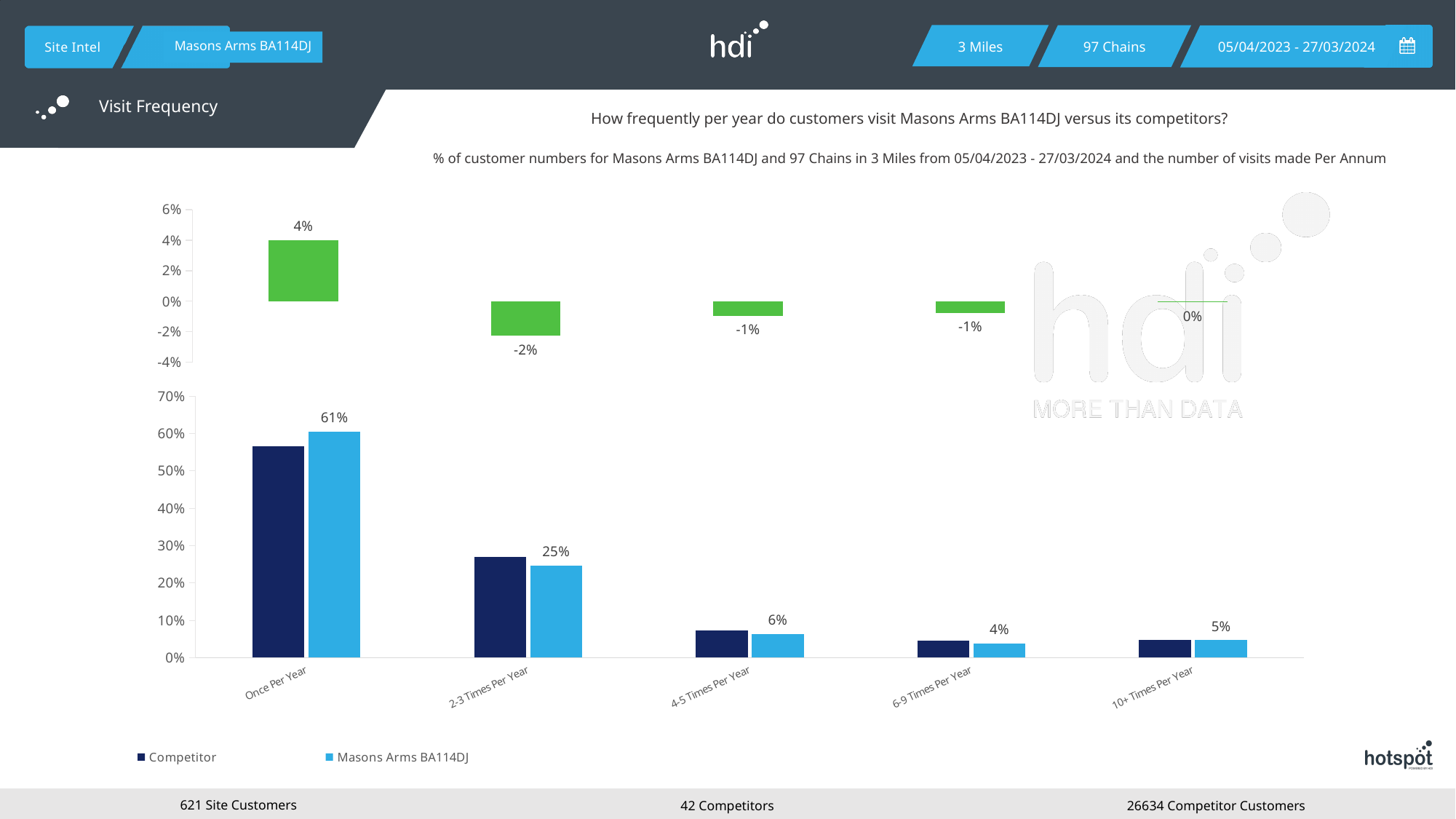
How many visit frequency categories are shown on the x axis of the bottom chart? 5 In the bottom chart, what is the difference between the Masons Arms BA114DJ values for Once Per Year and 2-3 Times Per Year? 36% In the top chart, what is the value shown for 2-3 Times Per Year? -2% In the bottom chart, what is the Masons Arms BA114DJ value for 2-3 Times Per Year? 25% In the top chart, what is the value shown for Once Per Year? 4% In the bottom chart, is the Competitor value for 4-5 Times Per Year greater or less than 10%? less In the bottom chart, is the Competitor value for Once Per Year greater or less than 50%? greater In the bottom chart, which visit frequency category has the lowest Masons Arms BA114DJ value? 6-9 Times Per Year How many series does the legend of the bottom chart list? 2 In the bottom chart, what is the Masons Arms BA114DJ value for 10+ Times Per Year? 5% In the bottom chart, what percentage of Masons Arms BA114DJ customers visit Once Per Year? 61% In the bottom chart, which visit frequency category has the highest Masons Arms BA114DJ value? Once Per Year